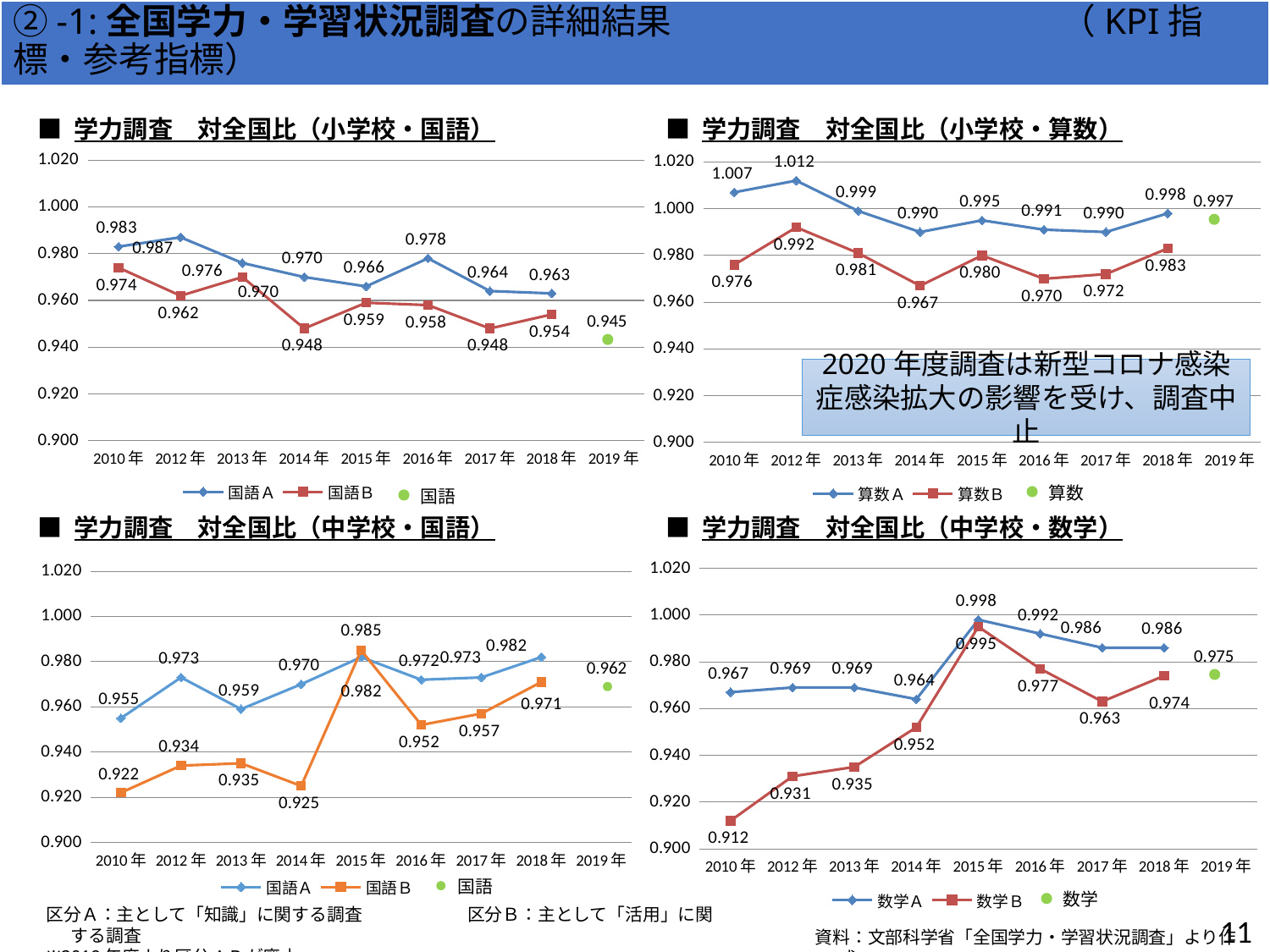
How many series does the legend of the 小学校・国語 chart (top left) list? 3 In the 小学校・算数 chart (top right), what is the value of the 算数 point in 2019年? 0.997 In the 中学校・数学 chart (bottom right), which year has the highest value for 数学A? 2015年 In the 中学校・国語 chart (bottom left), which is larger in 2015年, 国語A or 国語B? 国語B In the 中学校・数学 chart (bottom right), does 数学B rise or fall from 2010年 to 2015年? rise In the 小学校・国語 chart (top left), what is the value of 国語B in 2014年? 0.948 In the 小学校・算数 chart (top right), which year has the highest value for 算数A? 2012年 In the 中学校・数学 chart (bottom right), what is the value of 数学B in 2010年? 0.912 In the 中学校・国語 chart (bottom left), which year has the lowest value for 国語B? 2010年 In the 小学校・国語 chart (top left), what is the value of 国語A in 2010年? 0.983 What kind of chart is the 中学校・数学 chart (bottom right)? line chart In the 小学校・算数 chart (top right), what is the difference between 算数A and 算数B in 2010年? 0.031